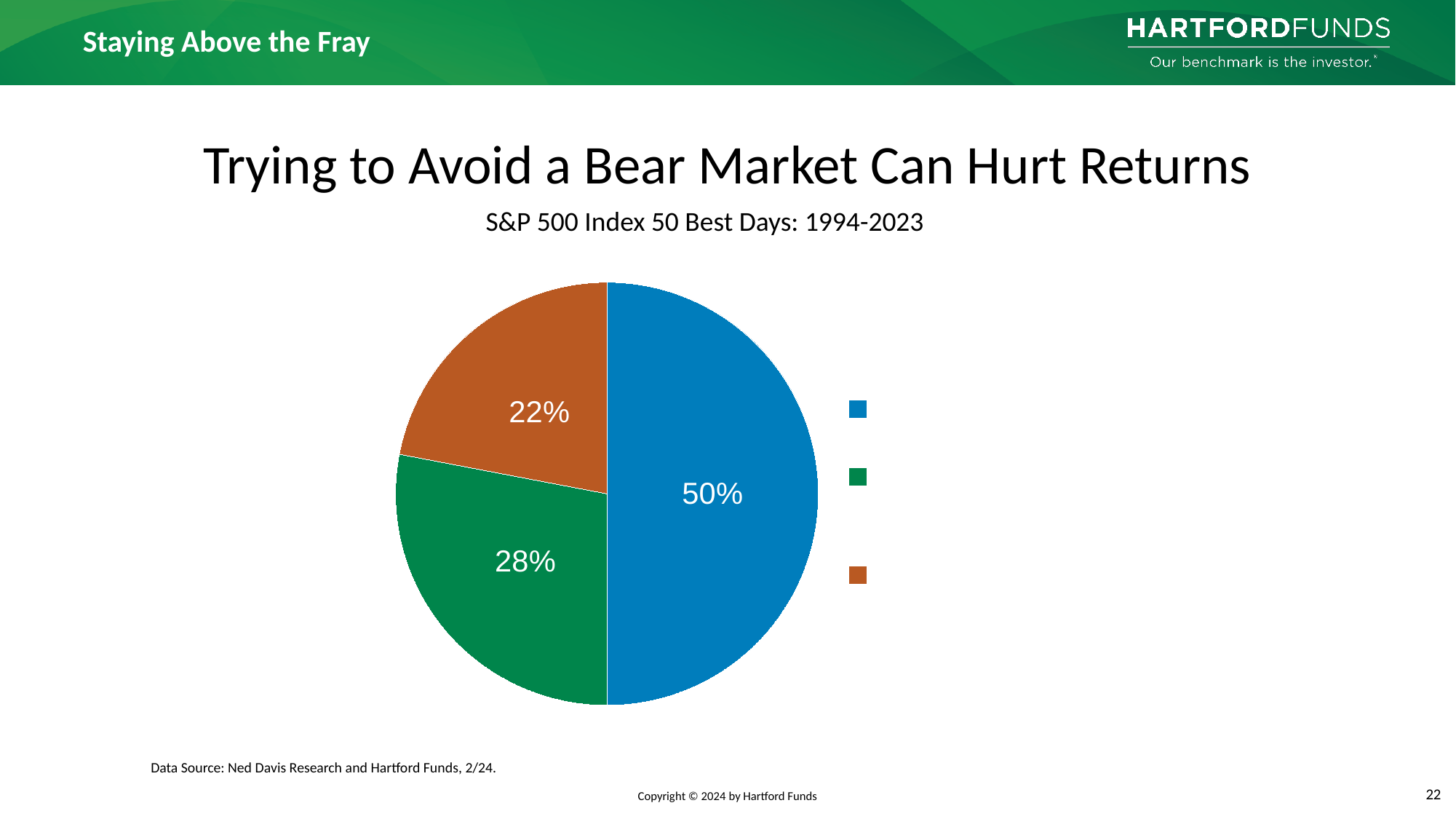
Which slice of the pie chart is the smallest? the orange slice (22%) What is the difference in percentage points between the blue slice and the green slice? 22 What percentage is shown on the green slice of the pie chart? 28% What percentage is shown on the orange slice of the pie chart? 22% Which slice of the pie chart is the largest? the blue slice (50%) What is the subtitle shown above the pie chart? S&P 500 Index 50 Best Days: 1994-2023 How many entries does the legend of the pie chart show? 3 Which is larger, the green slice or the orange slice? the green slice What is the difference in percentage points between the green slice and the orange slice? 6 What kind of chart is shown on the slide? pie chart How many slices does the pie chart have? 3 What percentage is shown on the blue slice of the pie chart? 50%